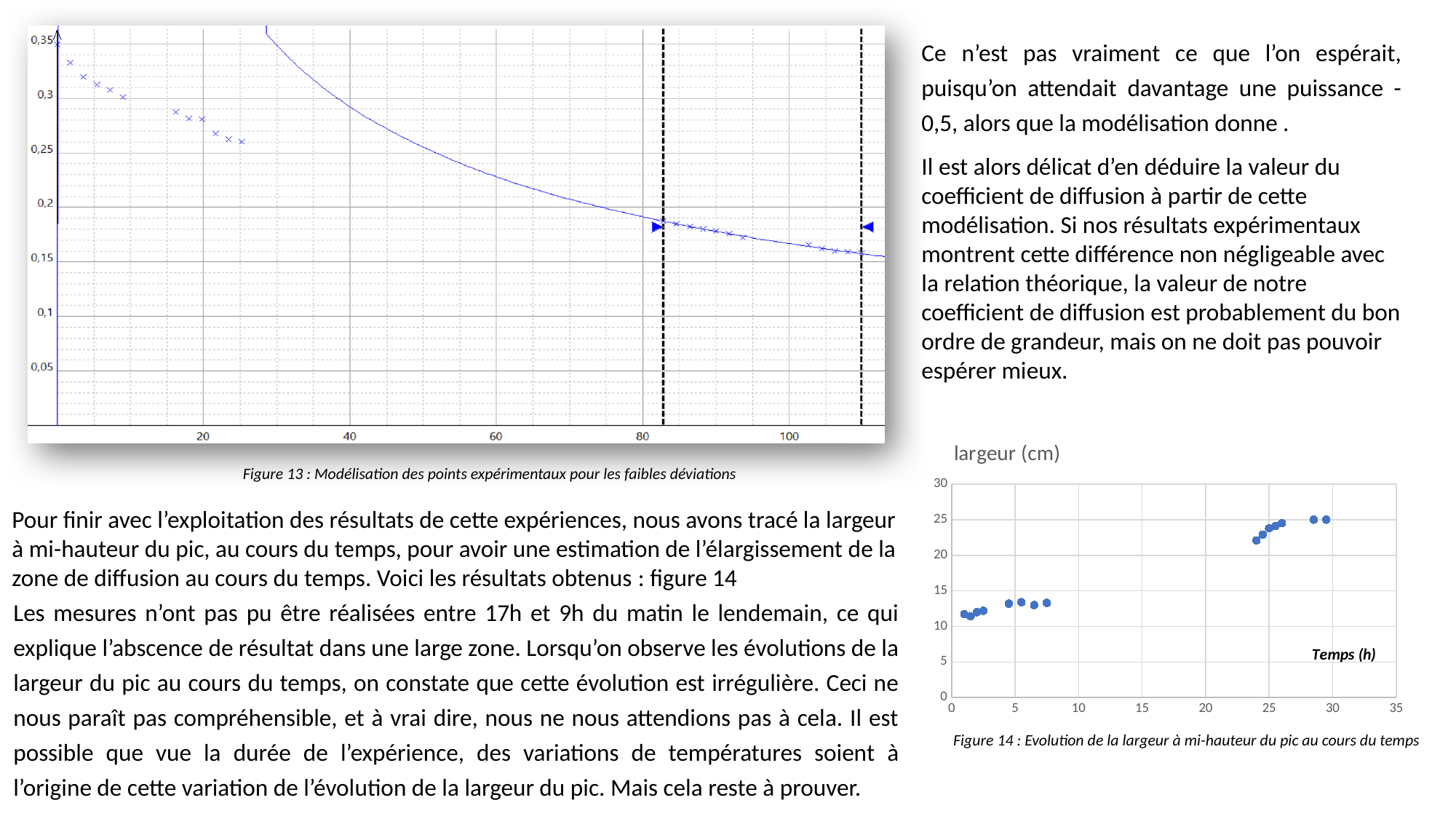
What is the x-axis label of Figure 14? Temps (h) In Figure 14, is the largeur value at about 29 h greater or less than 30? less In Figure 14, is the largeur value at about 1 h greater or less than 15? less In Figure 13, is the value of the points near x = 100 greater or less than 0.2? less What kind of chart is Figure 13? Scatter chart with a fitted curve What kind of chart is Figure 14 (Evolution de la largeur à mi-hauteur du pic au cours du temps)? Scatter chart In Figure 14, do the largeur values rise or fall as Temps increases along the x axis? Rise In Figure 13 (Modélisation des points expérimentaux pour les faibles déviations), do the plotted points rise or fall as the x value increases? Fall What is the y-axis title of Figure 14? largeur (cm)